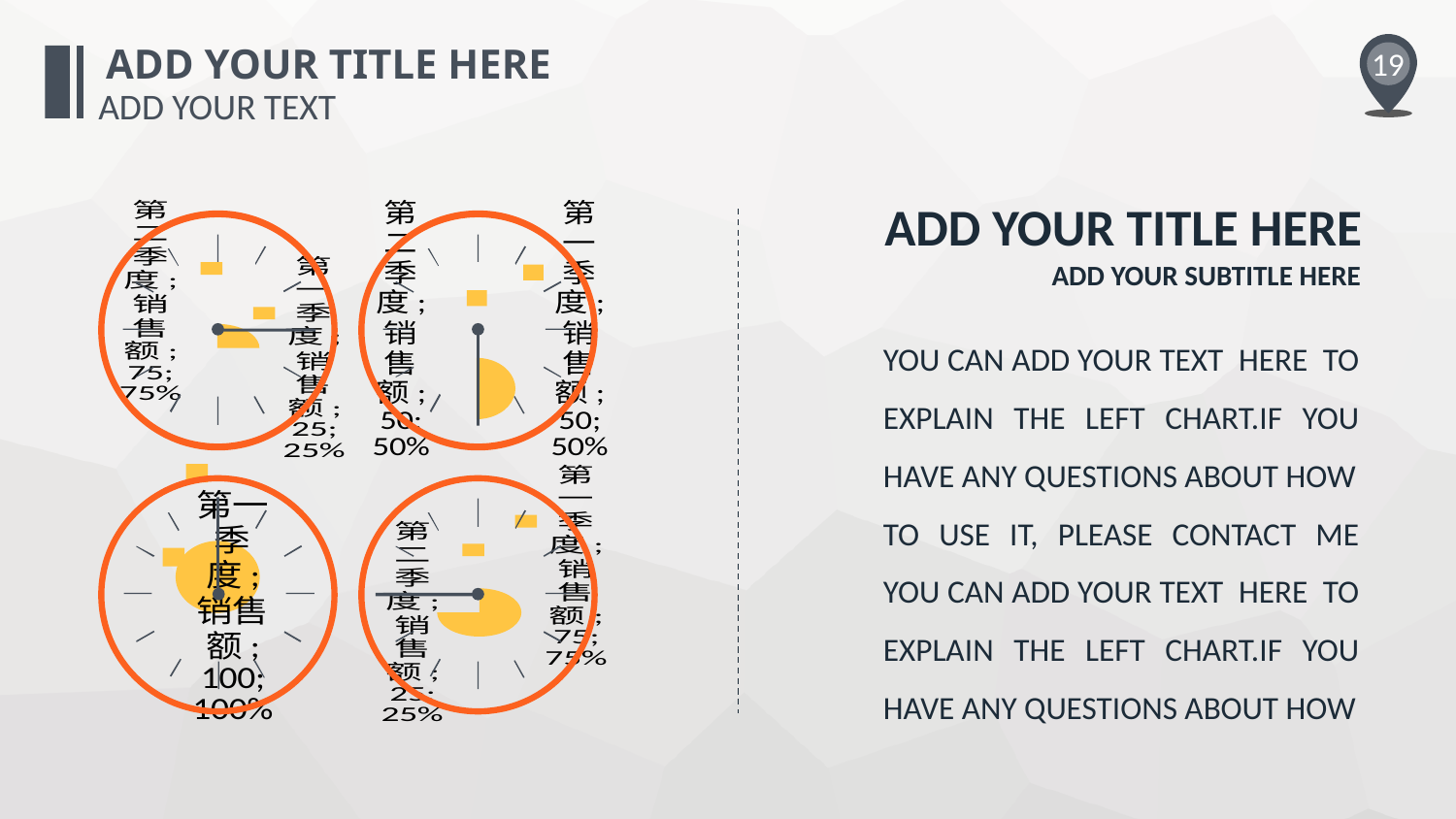
In the bottom-right chart, what percentage share is labelled for 第一季度销售额? 75% In the bottom-right chart, which slice is larger, 第一季度销售额 or 第二季度销售额? 第一季度销售额 How many charts are shown on the left side of the slide? 4 In the top-left chart, what percentage share is labelled for 第二季度销售额? 75% In the top-left chart, what percentage share is labelled for 第一季度销售额? 25% In the top-left chart, which slice is larger, 第一季度销售额 or 第二季度销售额? 第二季度销售额 In the bottom-right chart, what value is labelled for 第二季度销售额? 25 In the top-left chart, what value is labelled for 第二季度销售额? 75 What kind of chart is the top-left chart on the slide? pie chart In the top-right chart, what value is labelled for 第二季度销售额? 50